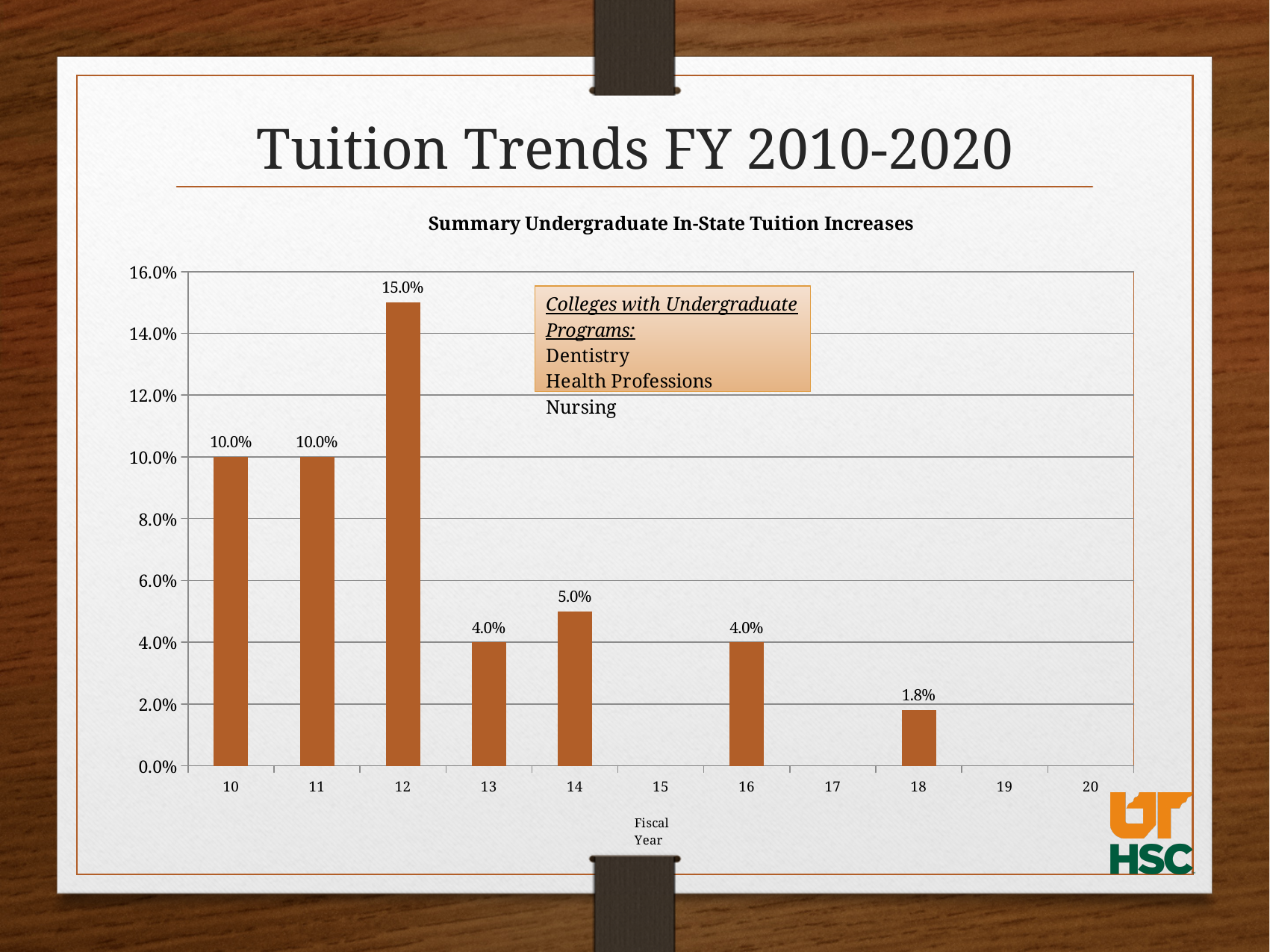
What is the difference between the tuition increase in fiscal year 14 and fiscal year 18? 3.2% What is the title of the chart? Summary Undergraduate In-State Tuition Increases What is the tuition increase for fiscal year 18? 1.8% What is the tuition increase for fiscal year 14? 5.0% What is the difference between the tuition increase in fiscal year 12 and fiscal year 13? 11.0% Which is larger, the tuition increase for fiscal year 11 or fiscal year 14? Fiscal year 11 How many fiscal years are labelled on the x axis? 11 What is the tuition increase for fiscal year 12? 15.0% What kind of chart is shown on the slide? Bar chart What is the label of the x axis? Fiscal Year Which fiscal year has the highest tuition increase? 12 Is the value for fiscal year 12 greater or less than 14.0%? greater